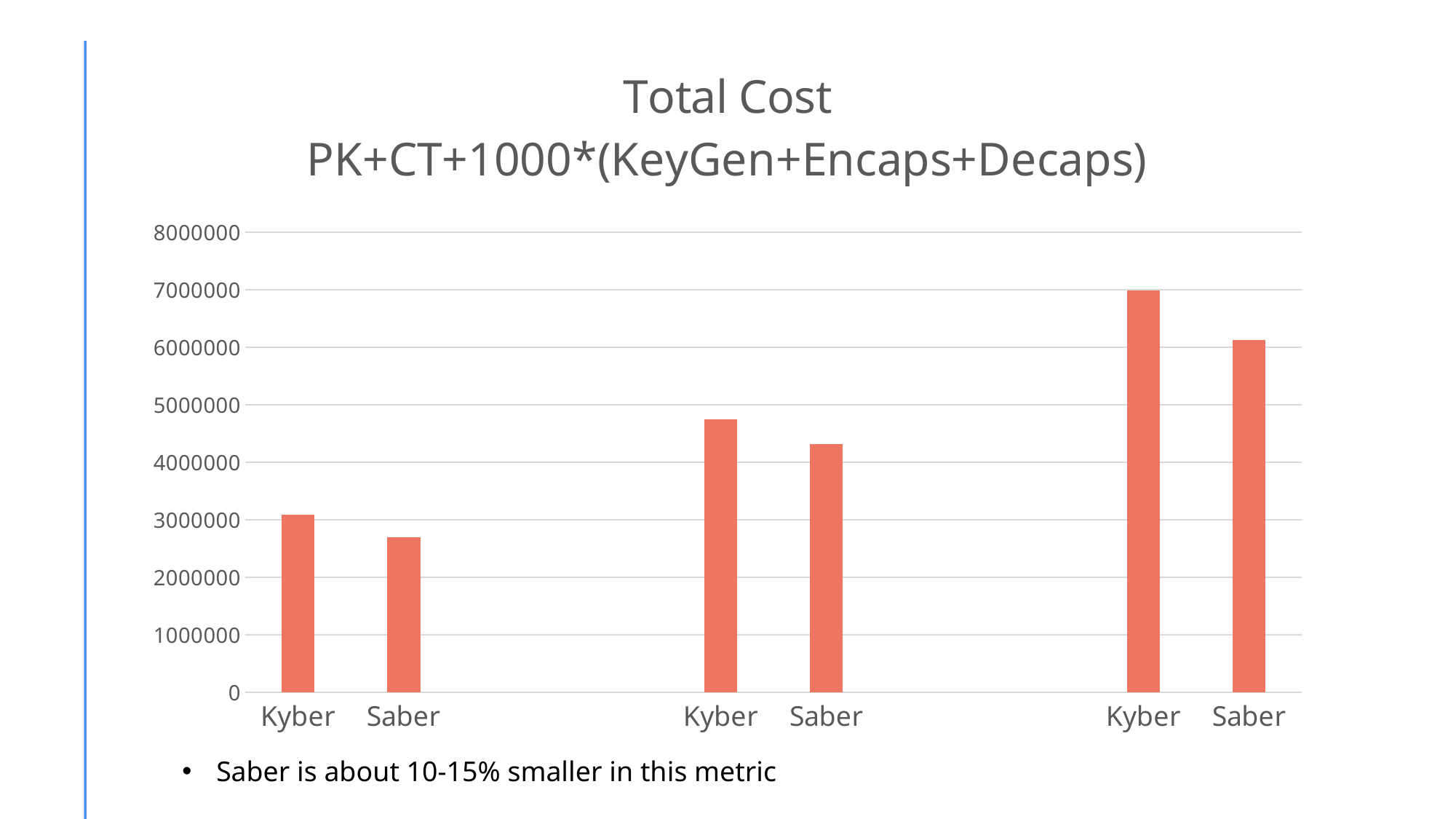
Is the value for the Kyber bar in the rightmost group greater or less than 6000000? greater What formula is given in the chart title for the total cost? PK+CT+1000*(KeyGen+Encaps+Decaps) Which bar is the tallest in the chart? Kyber in the rightmost group In the leftmost pair of bars, which is larger, Kyber or Saber? Kyber Is the value for the leftmost Saber bar greater or less than 3000000? less In the rightmost pair of bars, which is larger, Kyber or Saber? Kyber Which bar is the shortest in the chart? Saber in the leftmost group What kind of chart is shown on the slide? bar chart Do the bar heights generally rise or fall moving from the leftmost group to the rightmost group? rise Is the value for the Kyber bar in the middle group greater or less than 5000000? less How many bars are plotted in the chart? 6